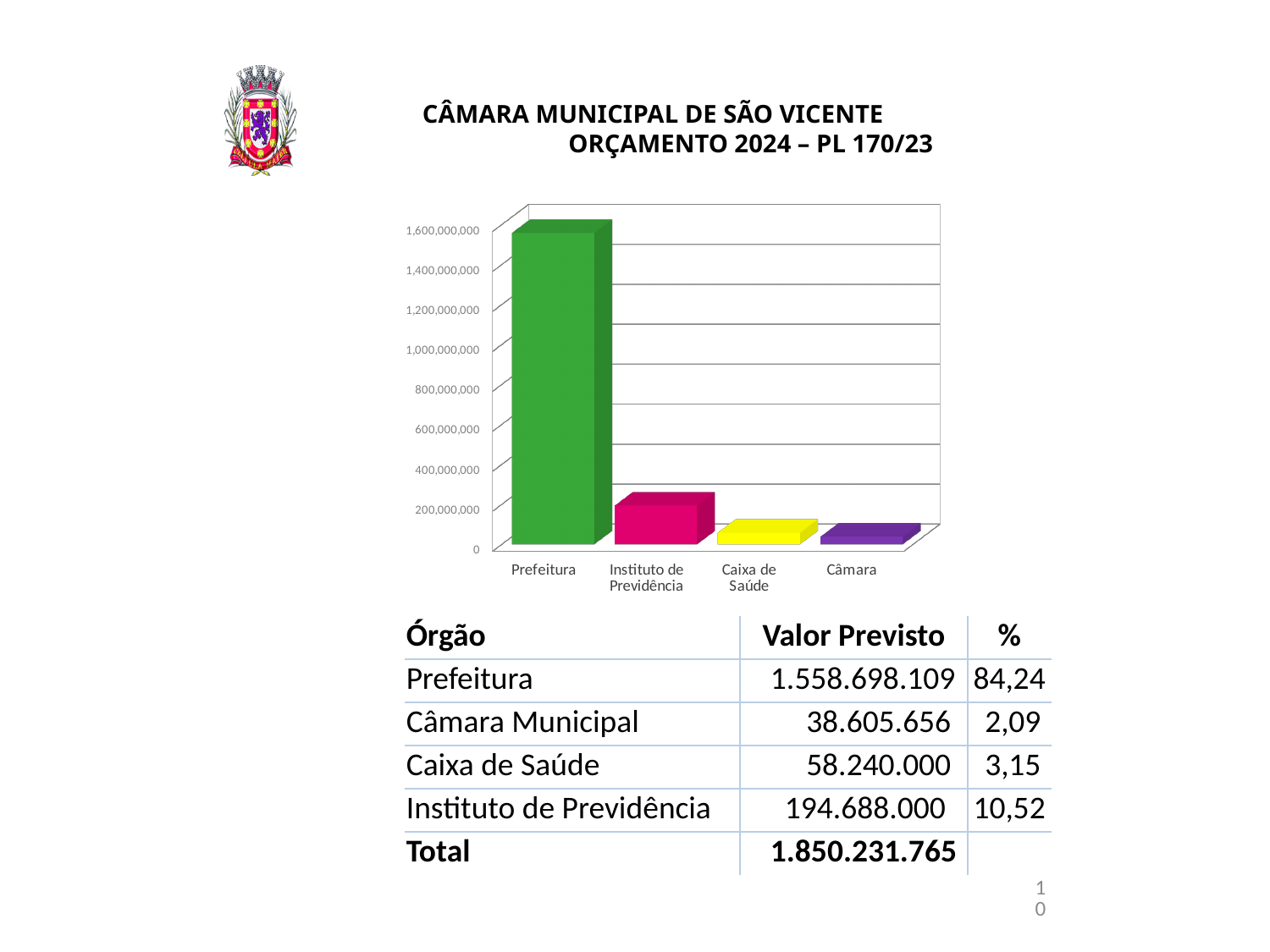
According to the table below the chart, what is the Valor Previsto for Instituto de Previdência? 194.688.000 Is the value for Instituto de Previdência greater or less than 400,000,000? less What kind of chart is shown on the slide? bar chart How many categories are plotted on the chart? 4 Which category has the shortest bar in the chart? Câmara Is the value for Prefeitura greater or less than 1,400,000,000? greater Which category has the tallest bar in the chart? Prefeitura What is the total Valor Previsto shown in the table below the chart? 1.850.231.765 What colour is the bar for Prefeitura? green Which is larger, the bar for Instituto de Previdência or the bar for Caixa de Saúde? Instituto de Previdência Is the value for Caixa de Saúde greater or less than 200,000,000? less According to the table below the chart, what is the Valor Previsto for Prefeitura? 1.558.698.109